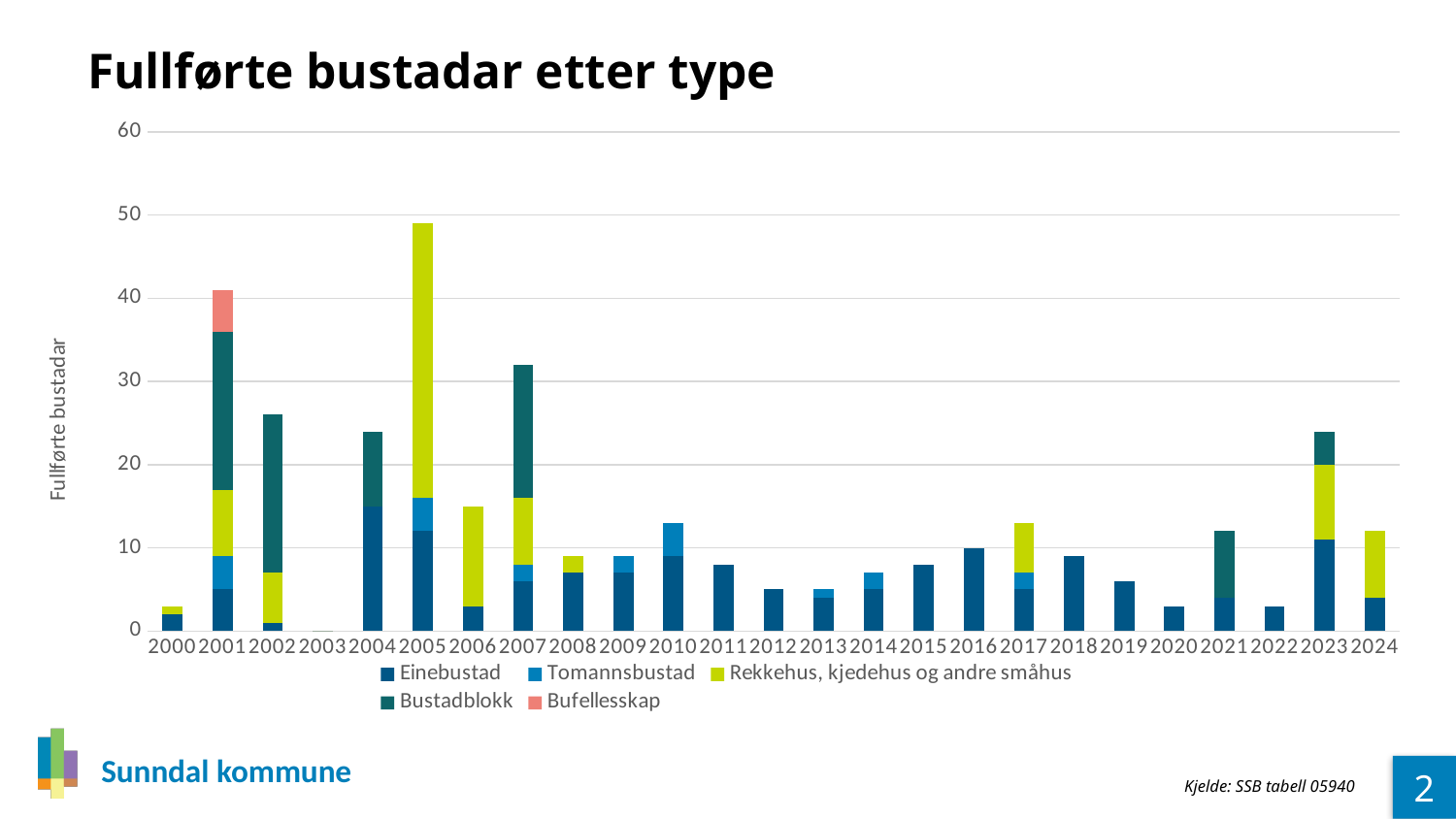
How many series does the legend list? 5 Which year has the lowest total of completed dwellings? 2003 How many years are shown along the x axis? 25 Which year has the highest total of completed dwellings? 2005 Does the total rise or fall from 2023 to 2024? fall Is the total for 2023 greater or less than 20? greater What is the title of the chart? Fullførte bustadar etter type Is the total for 2001 greater or less than 30? greater Which year has the larger total, 2001 or 2002? 2001 Is the total for 2005 greater or less than 40? greater What kind of chart is shown on the slide? Stacked bar chart